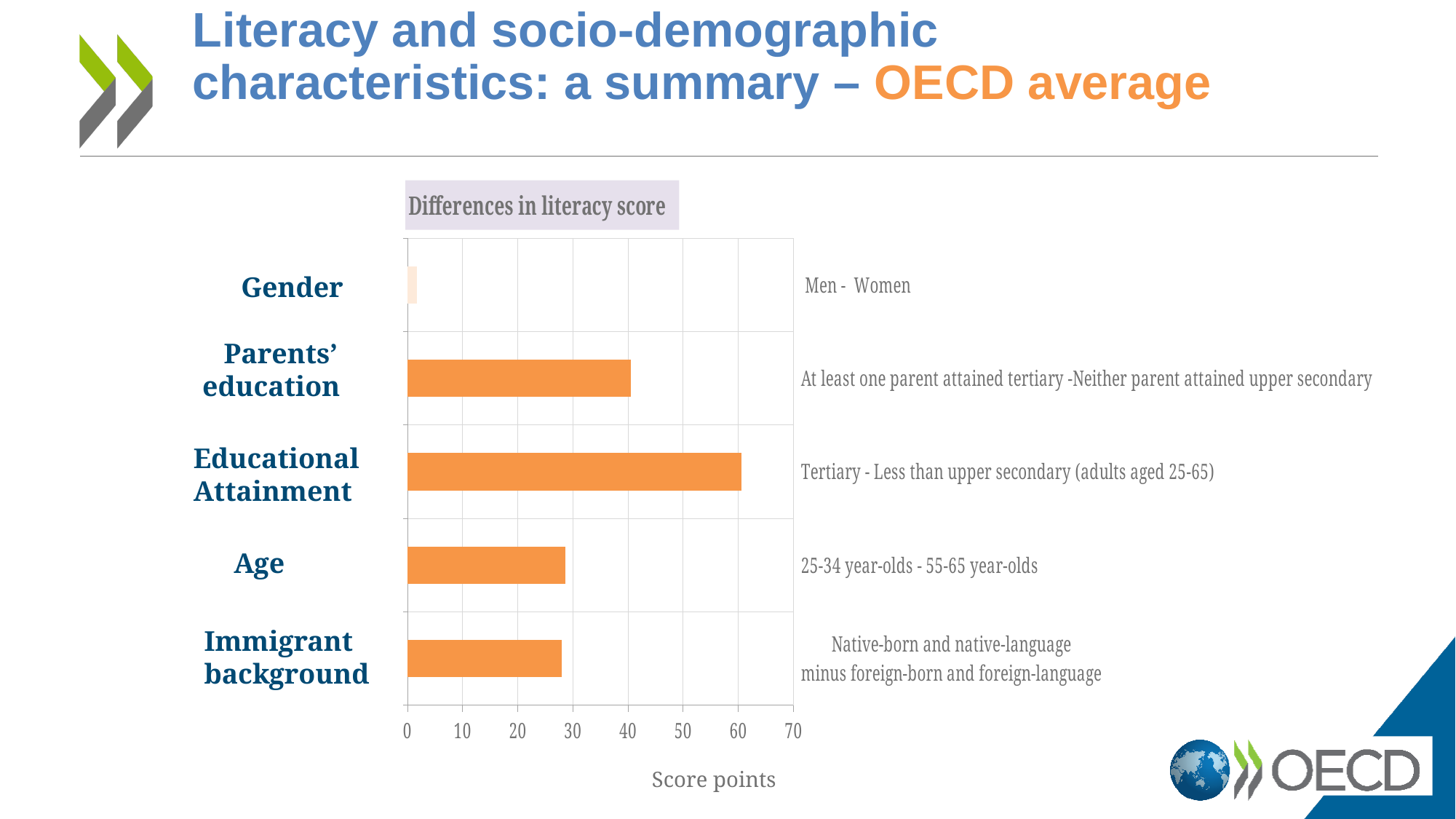
How many categories are plotted in the chart? 5 What is the title of the chart? Differences in literacy score Which is larger, the value for Parents' education or the value for Age? Parents' education Is the value for Gender greater or less than 10? less Is the value for Immigrant background greater or less than 40? less Which category has the highest difference in literacy score? Educational Attainment What kind of chart is shown on the slide? bar chart What is the label of the horizontal axis? Score points Is the value for Age greater or less than 20? greater Which category has the lowest difference in literacy score? Gender